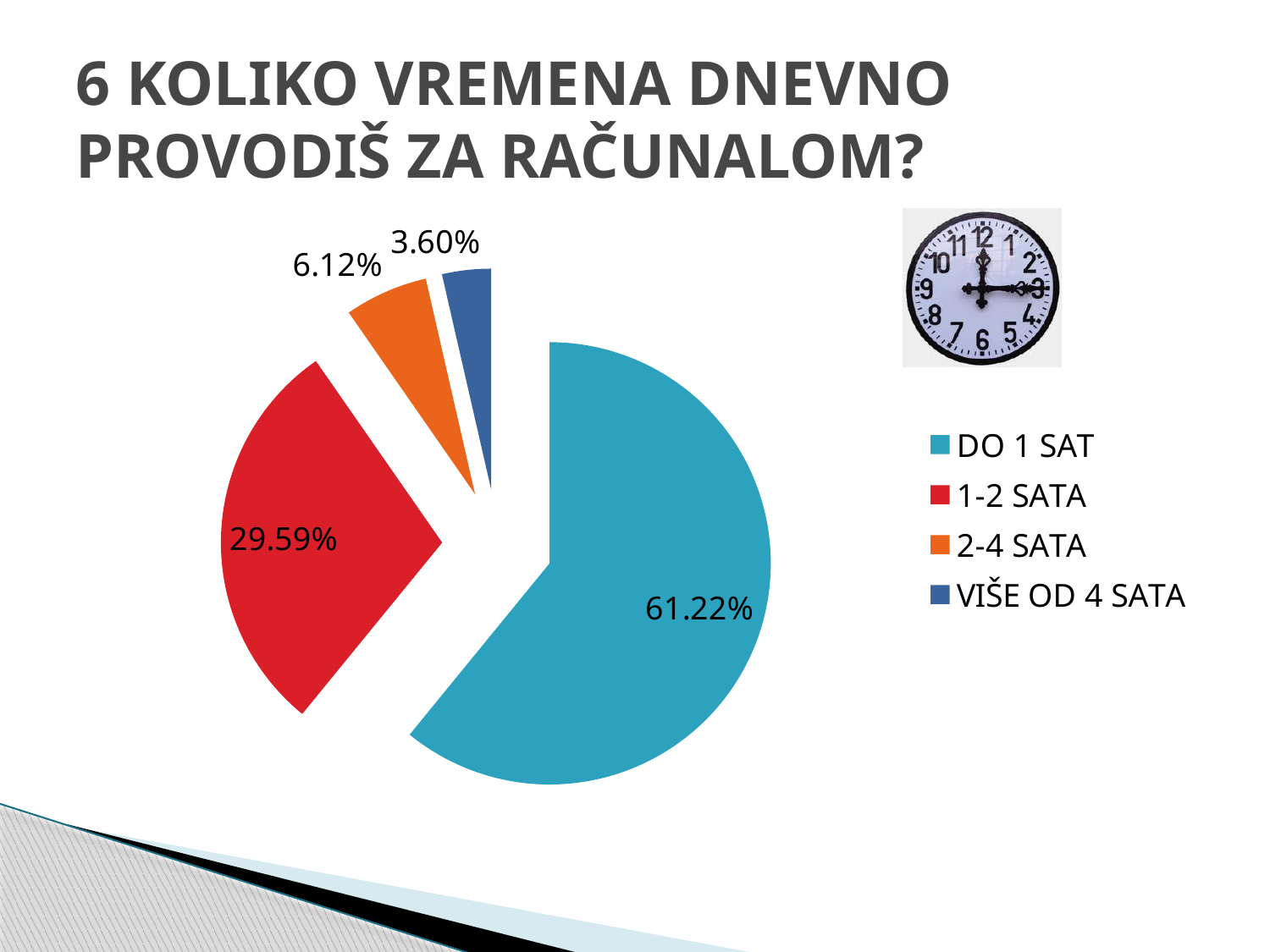
What colour is the slice for 1-2 SATA? Red What percentage is shown for the 2-4 SATA slice? 6.12% What percentage is shown for the VIŠE OD 4 SATA slice? 3.60% What kind of chart is shown on the slide? Pie chart What is the difference in percentage points between the DO 1 SAT and 1-2 SATA slices? 31.63 What is the combined percentage of the 2-4 SATA and VIŠE OD 4 SATA slices? 9.72% Which slice is larger, 2-4 SATA or VIŠE OD 4 SATA? 2-4 SATA What percentage is shown for the 1-2 SATA slice? 29.59% Which category has the largest share of the pie? DO 1 SAT What percentage of the pie is the DO 1 SAT slice? 61.22% How many slices does the pie chart have? 4 Which category has the smallest share of the pie? VIŠE OD 4 SATA